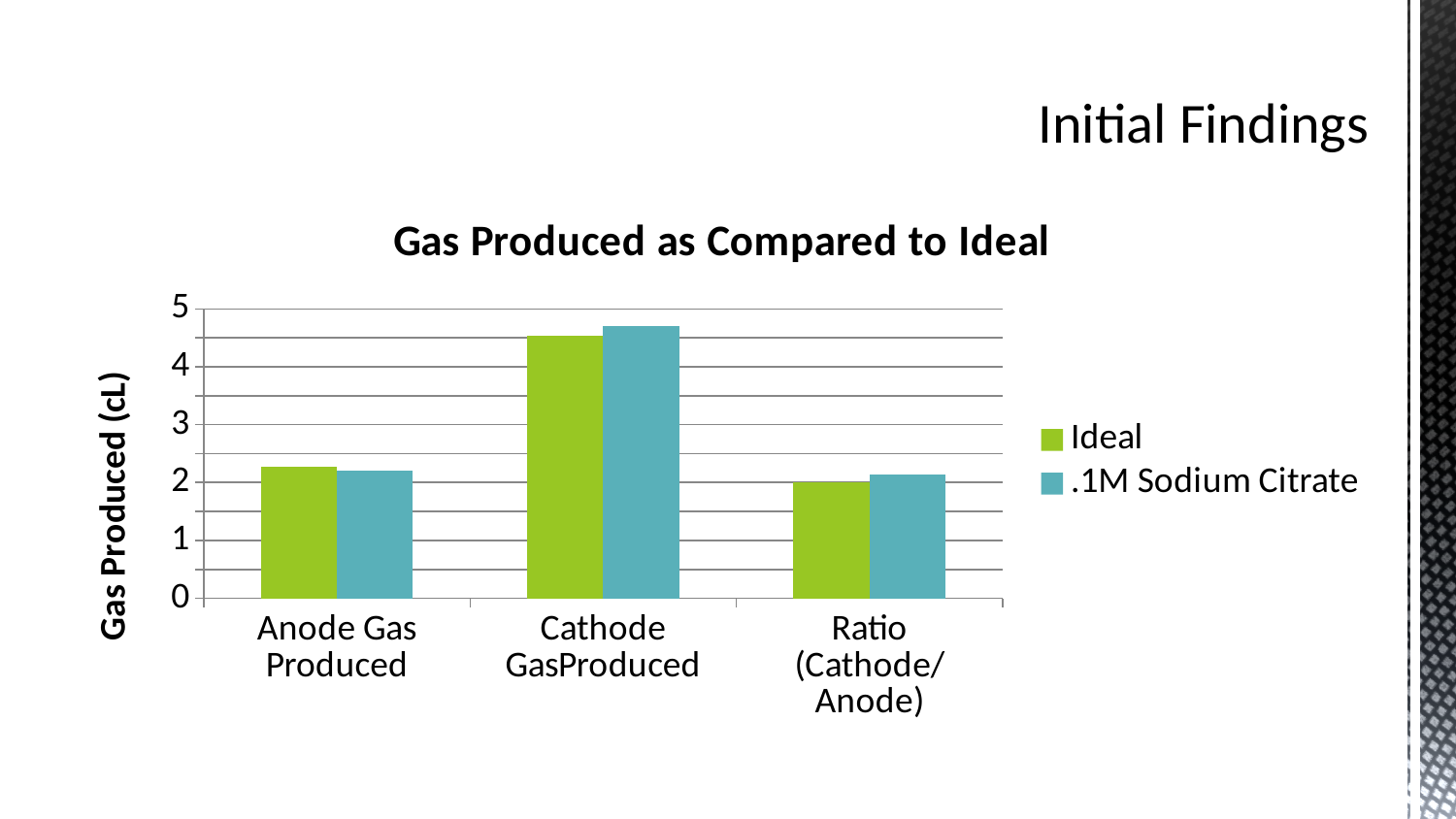
What is the label on the vertical axis? Gas Produced (cL) For Cathode GasProduced, which series has the larger value, Ideal or .1M Sodium Citrate? .1M Sodium Citrate How many series does the legend list? 2 Is the Ideal value for Anode Gas Produced greater or less than 2? greater What kind of chart is shown on the slide? bar chart What is the title of the chart? Gas Produced as Compared to Ideal Is the Ideal value for Cathode GasProduced greater or less than 4? greater Which category has the lowest value for the .1M Sodium Citrate series? Ratio (Cathode/Anode) Which category has the highest value for the Ideal series? Cathode GasProduced Is the .1M Sodium Citrate value for Cathode GasProduced greater or less than 4? greater How many categories are shown on the x axis? 3